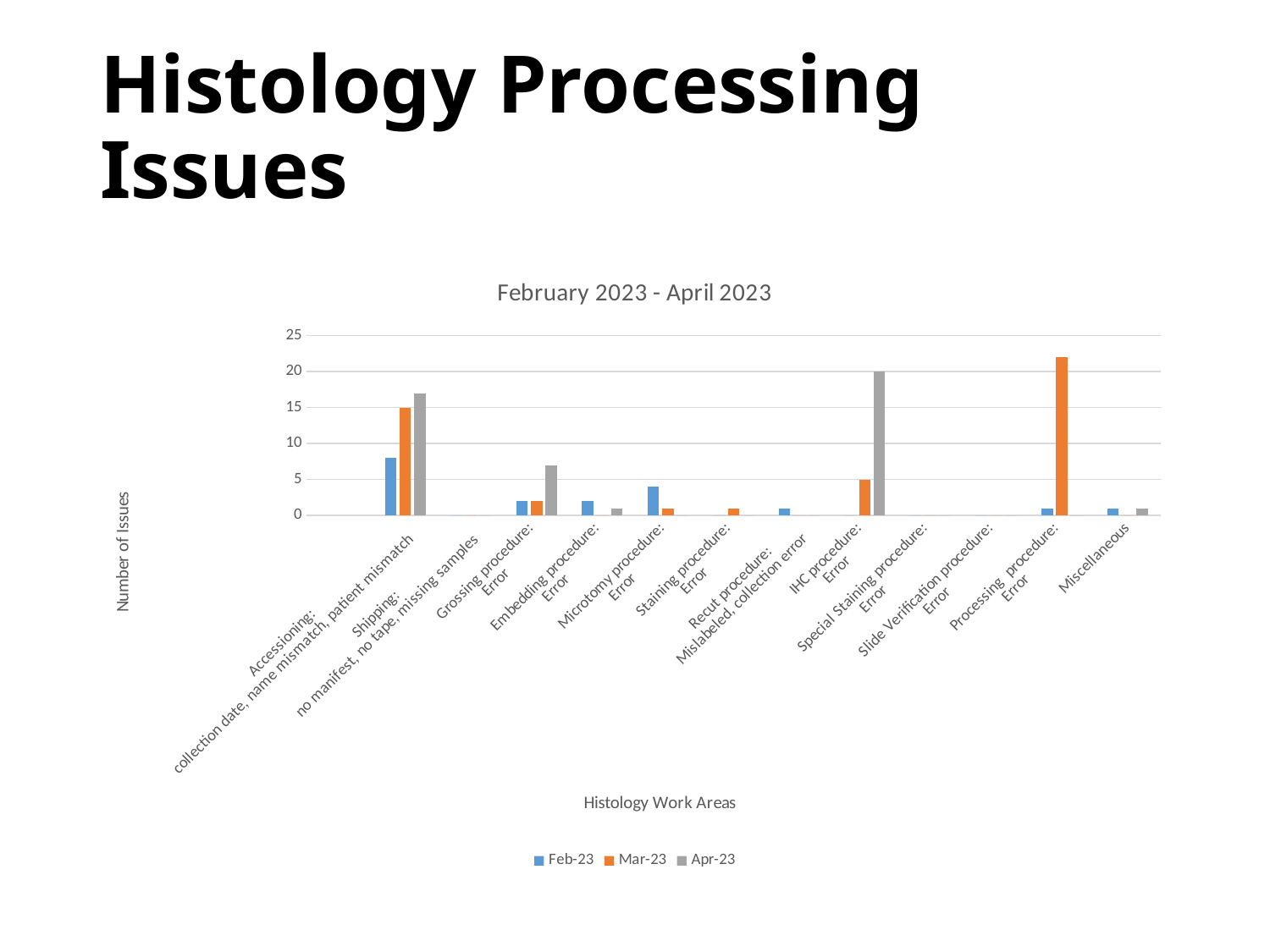
Which category has the tallest bar in the chart? Processing procedure: Error Which series is shown in orange in the legend? Mar-23 Which is larger for Accessioning, the Feb-23 value or the Mar-23 value? Mar-23 Which category has the highest Apr-23 value? IHC procedure: Error What kind of chart is shown on the slide? bar chart How many histology work area categories are shown on the x axis? 12 Is the Feb-23 value for Accessioning greater or less than 10? less Is the Apr-23 value for Accessioning greater or less than 15? greater Which is larger for IHC procedure: Error, the Mar-23 value or the Apr-23 value? Apr-23 How many series does the legend list? 3 Is the Mar-23 value for Processing procedure: Error greater or less than 20? greater What is the title of the chart? February 2023 - April 2023